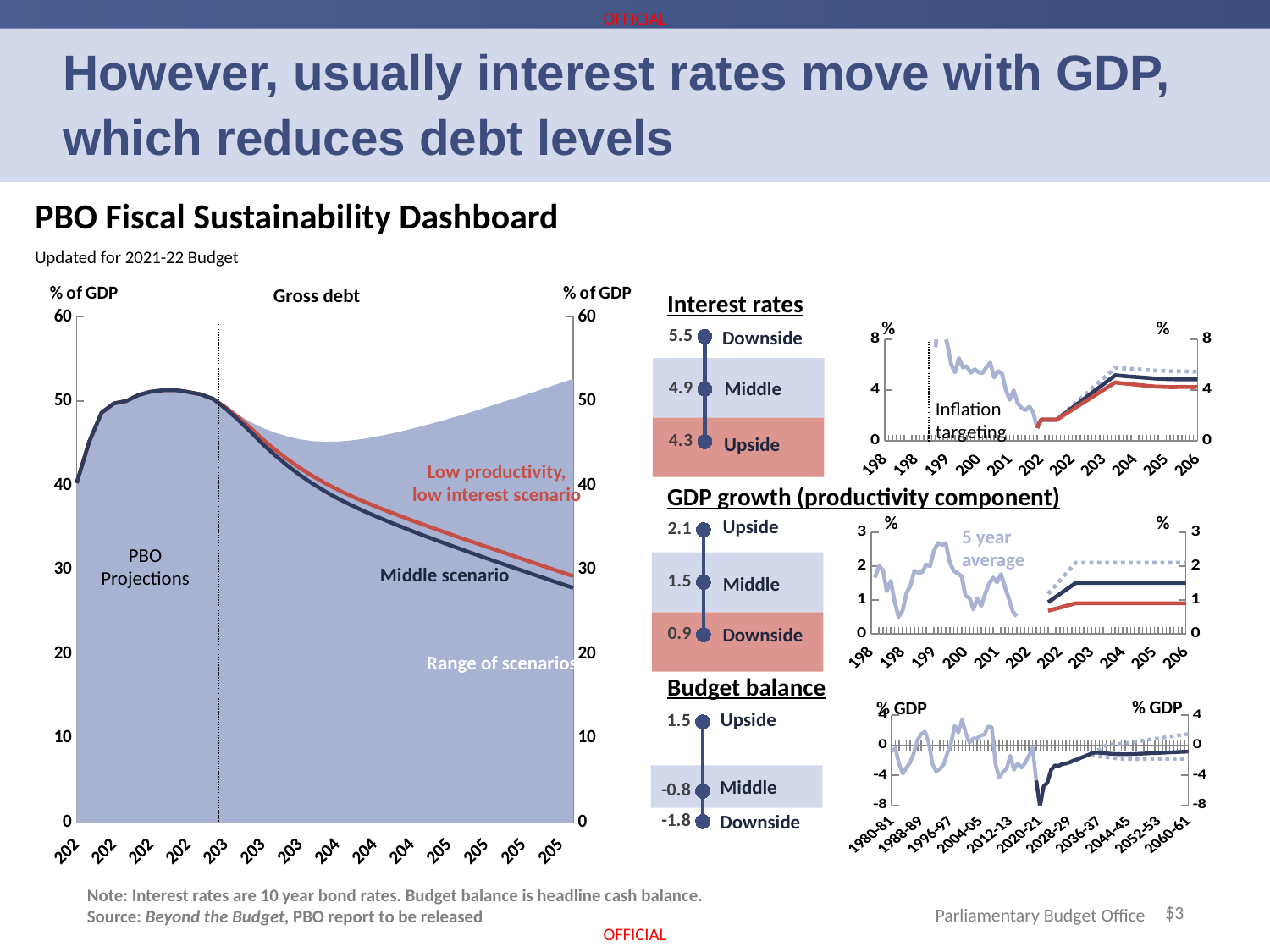
On the GDP growth (productivity component) panel, what is the difference between the Upside value and the Downside value? 1.2 On the GDP growth (productivity component) panel, what is the value shown for the Middle scenario? 1.5 On the Interest rates chart, do the historical interest rate values generally rise or fall from the 1980s to around 2020? fall On the Budget balance panel, what is the value shown for the Downside scenario? -1.8 On the Interest rates panel, what is the value shown for the Downside scenario? 5.5 On the Interest rates panel, what is the difference between the Downside value and the Upside value? 1.2 On the Gross debt chart, is the Middle scenario value at the right-hand end of the chart greater or less than 30? less What unit is shown on the vertical axis of the Gross debt chart? % of GDP On the Interest rates panel, what is the value shown for the Upside scenario? 4.3 On the Budget balance panel, what is the value shown for the Middle scenario? -0.8 On the Budget balance panel, which scenario has the lowest value? Downside On the Gross debt chart, at the right-hand end of the chart, which line is higher: the Low productivity, low interest scenario or the Middle scenario? Low productivity, low interest scenario